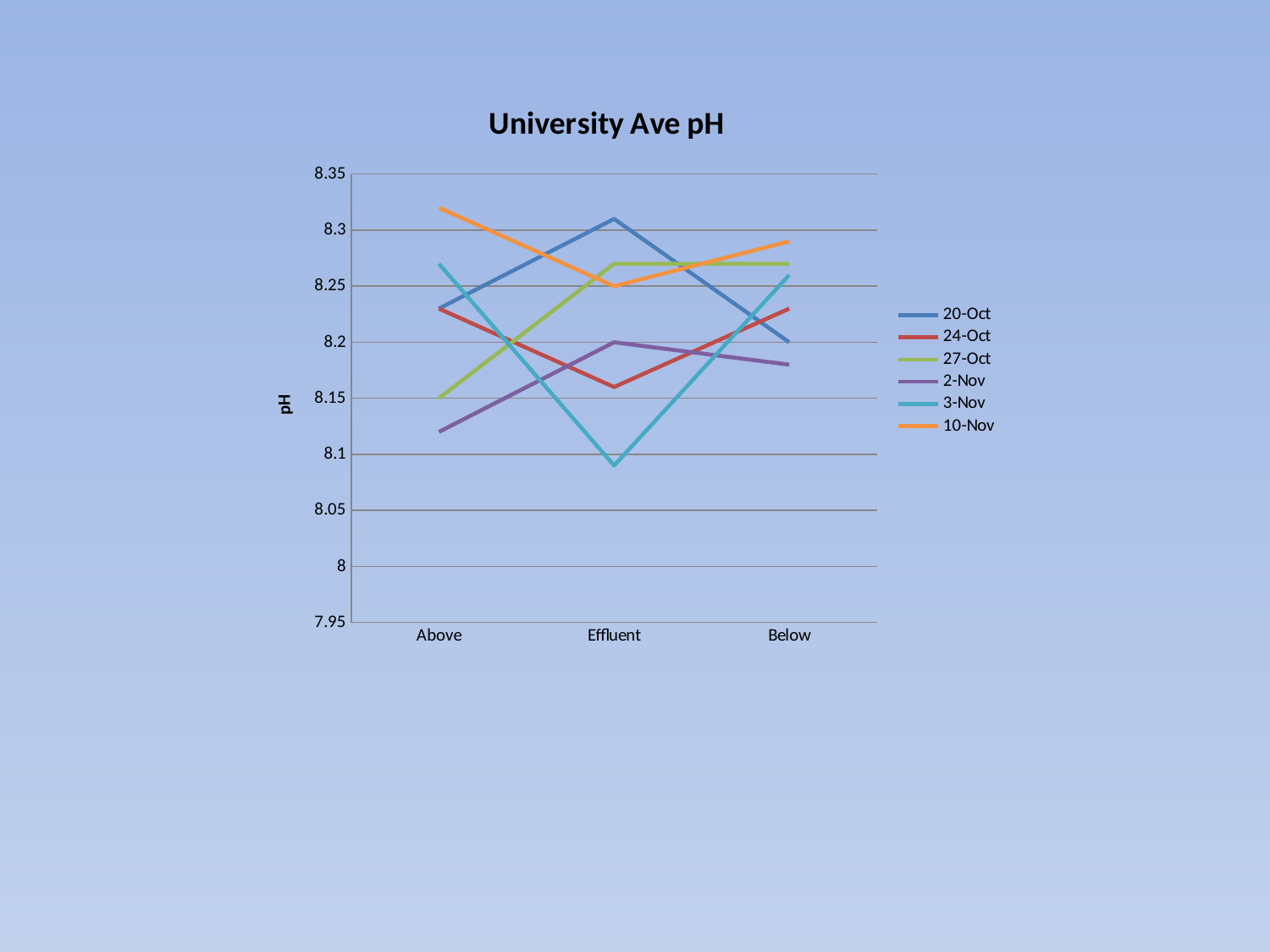
What is the title of the chart? University Ave pH How many series does the legend list? 6 Does the 3-Nov series rise or fall from Above to Effluent? fall What is the label of the vertical axis? pH How many categories are shown on the x axis? 3 What kind of chart is shown on the slide? line chart Which series has the lowest value at Effluent? 3-Nov Is the value for 20-Oct at Effluent greater or less than 8.3? greater Is the value for 3-Nov at Effluent greater or less than 8.1? less Which series has the highest value at Above? 10-Nov Which series has the lowest value at Above? 2-Nov Is the value for 10-Nov at Above greater or less than 8.3? greater